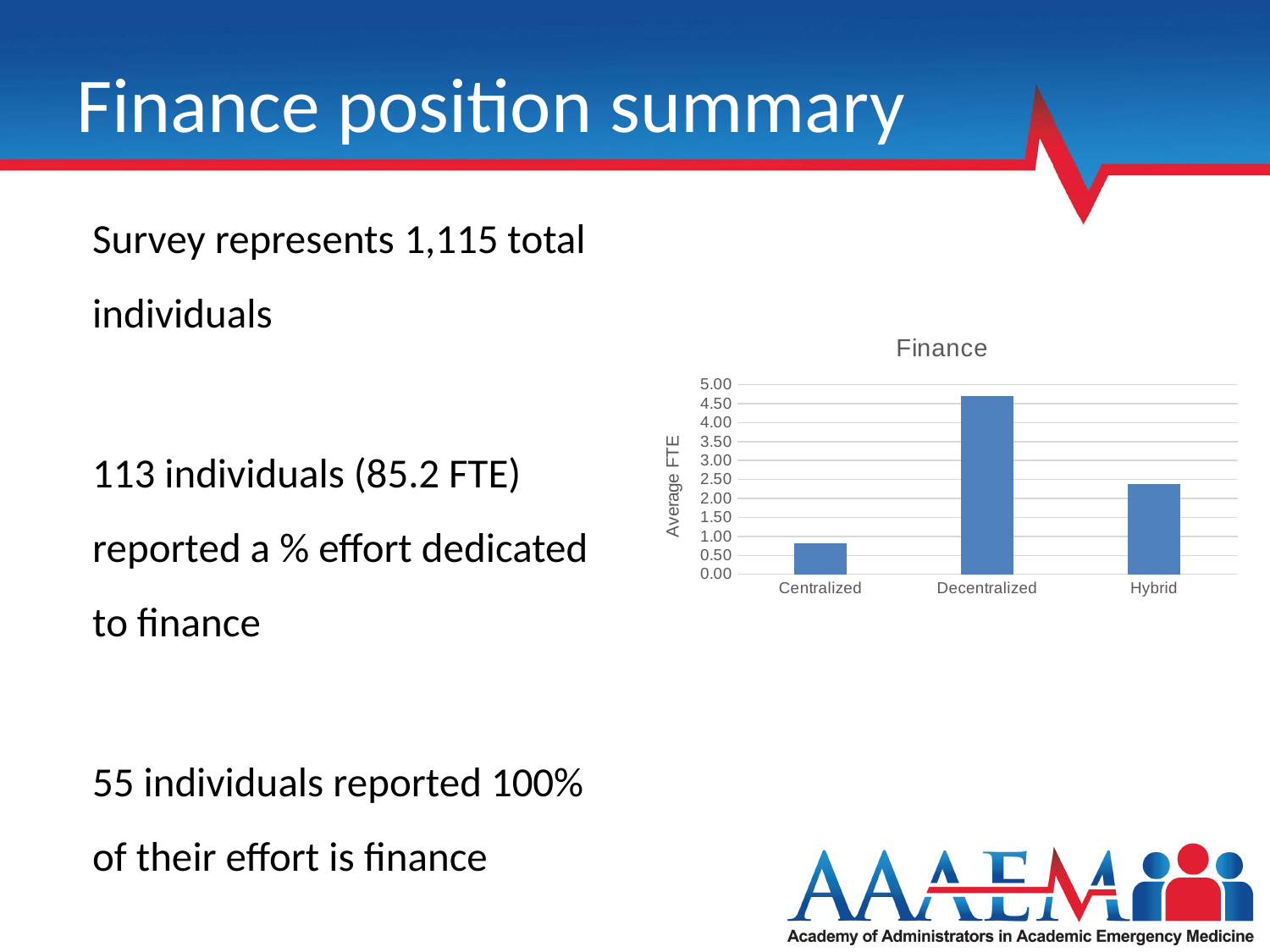
How many categories are shown on the x axis of the chart? 3 Is the value for Centralized greater or less than 1.00? less Which has a larger average FTE, Hybrid or Centralized? Hybrid Which has a larger average FTE, Decentralized or Hybrid? Decentralized Is the value for Hybrid greater or less than 3.00? less Which category has the lowest average FTE? Centralized What is the title of the chart? Finance Is the value for Hybrid greater or less than 2.00? greater Which category has the highest average FTE? Decentralized What type of chart is shown on the slide? bar chart What is the label of the vertical axis of the chart? Average FTE